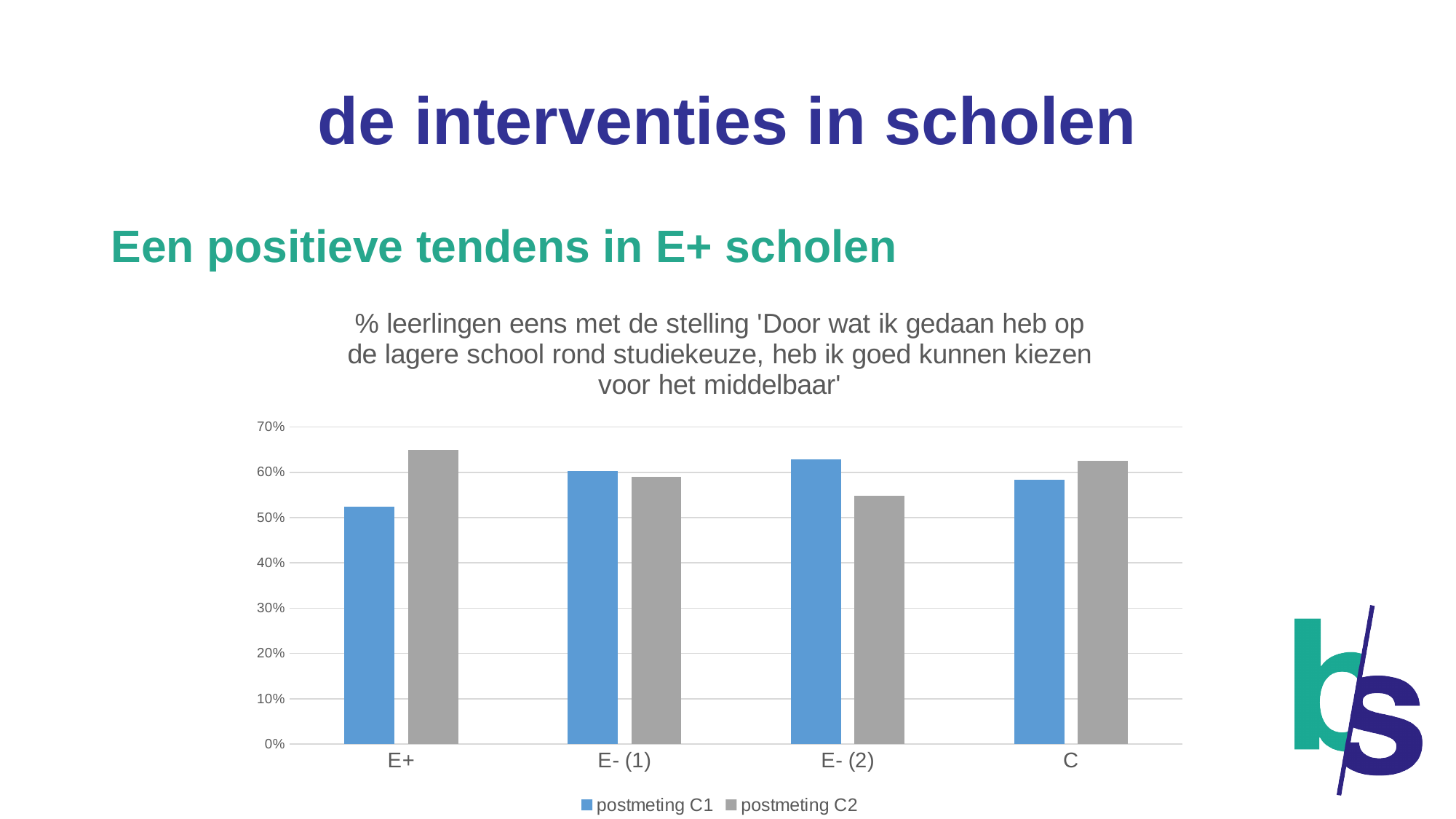
For E+, which is larger: postmeting C1 or postmeting C2? postmeting C2 What kind of chart is shown on the slide? bar chart What are the two series named in the legend? postmeting C1 and postmeting C2 Which category has the lowest value for postmeting C1? E+ Which category has the lowest value for postmeting C2? E- (2) Is the postmeting C2 value for E- (2) greater or less than 60%? less Which category has the highest value for postmeting C1? E- (2) Is the postmeting C1 value for E+ greater or less than 60%? less Is the postmeting C2 value for E+ greater or less than 60%? greater How many series does the chart's legend list? 2 How many categories are shown on the x axis of the chart? 4 For E- (2), which is larger: postmeting C1 or postmeting C2? postmeting C1